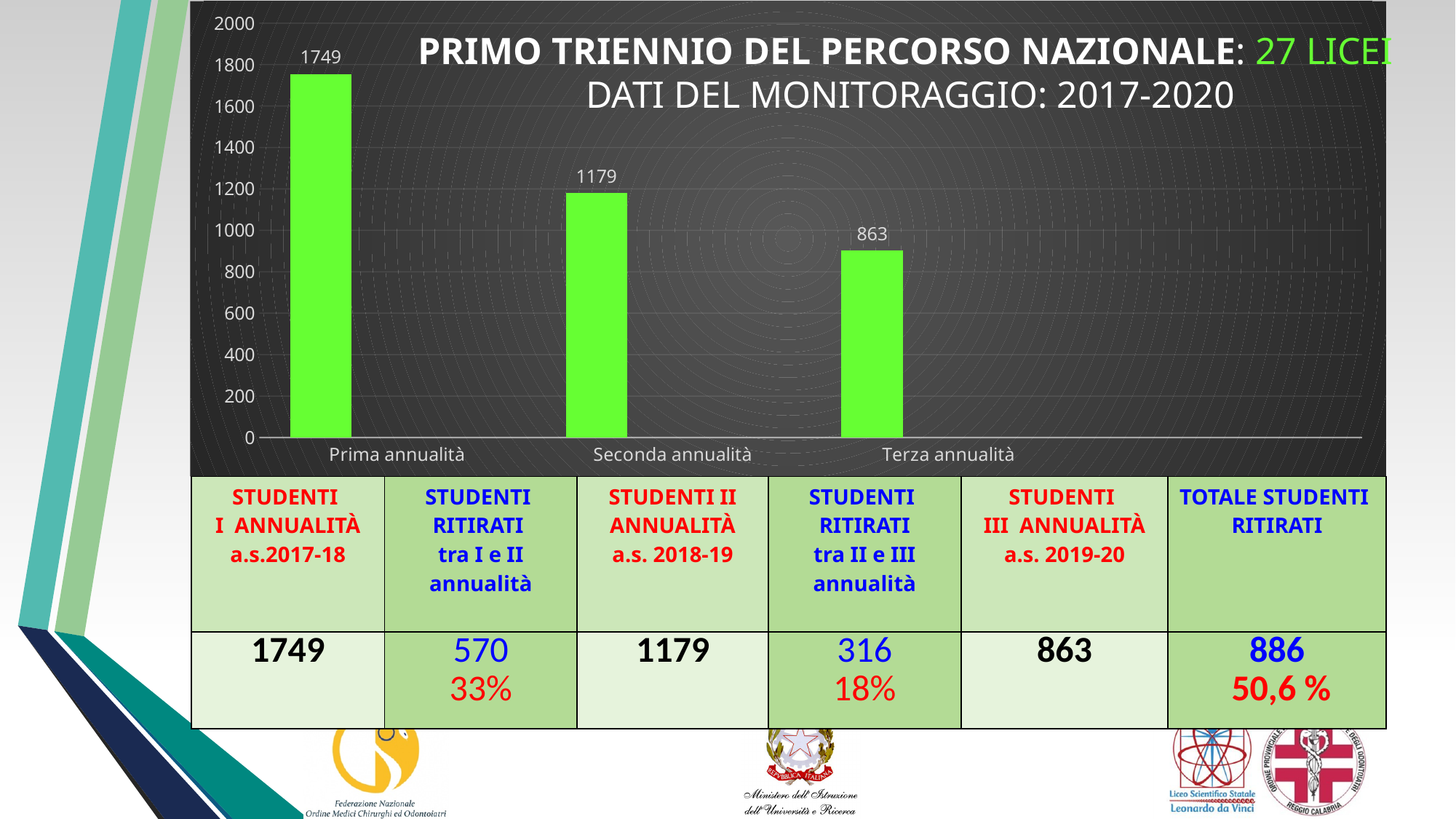
Is the value for Terza annualità greater or less than 1000? less What is the value for Terza annualità? 863 What kind of chart is shown on the slide? bar chart Which category has the highest value? Prima annualità What is the difference between the values for Prima annualità and Seconda annualità? 570 Do the values rise or fall from Prima annualità to Terza annualità? fall What is the value for Seconda annualità? 1179 Which is larger, the value for Seconda annualità or the value for Terza annualità? Seconda annualità What is the value for Prima annualità? 1749 Which category has the lowest value? Terza annualità How many categories are shown on the x axis? 3 What is the difference between the values for Seconda annualità and Terza annualità? 316